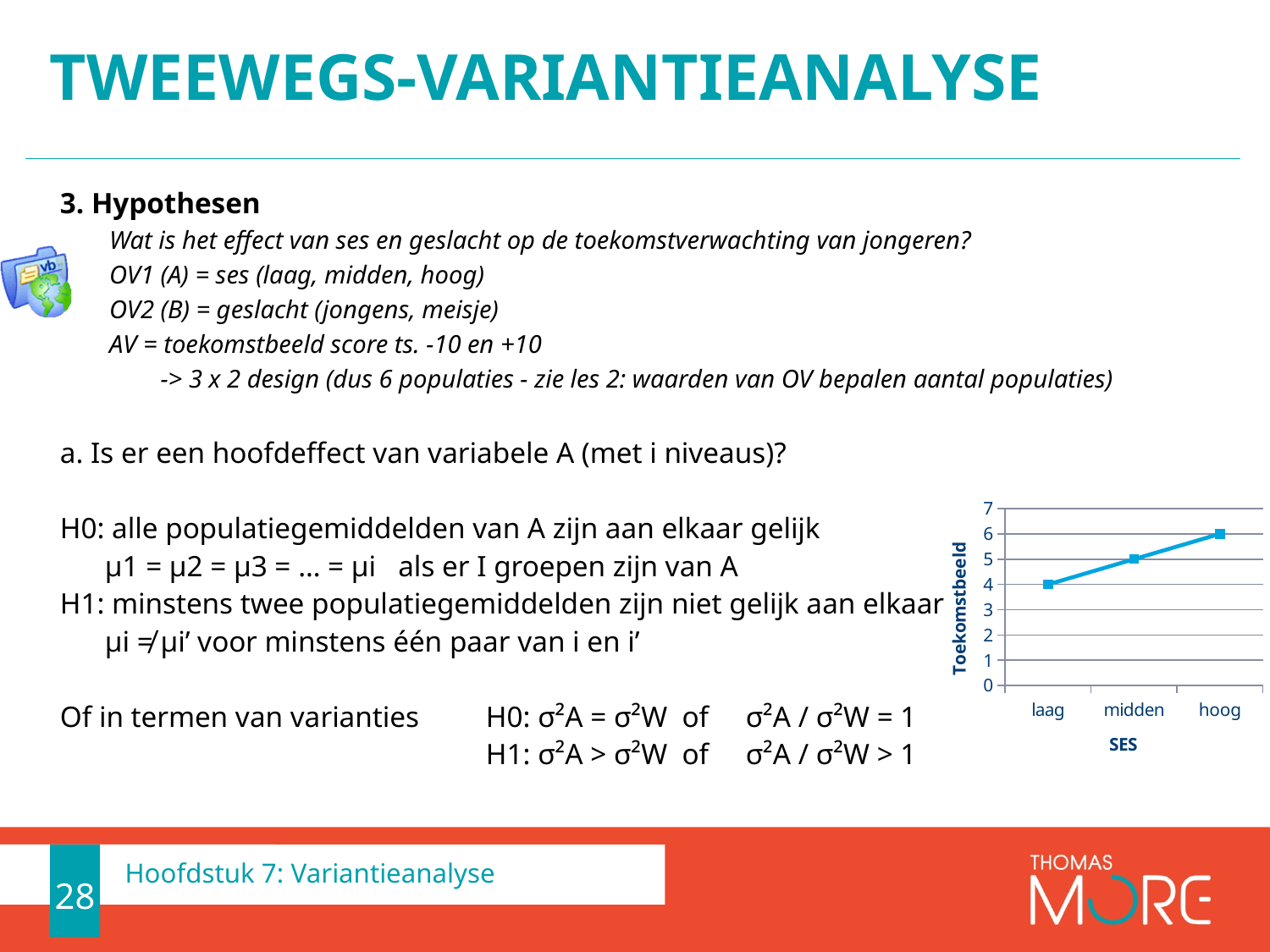
Which SES category has the lowest Toekomstbeeld value? laag Do the Toekomstbeeld values rise or fall from 'laag' to 'hoog'? rise Which SES category has the highest Toekomstbeeld value? hoog What is the Toekomstbeeld value for the SES category 'midden'? 5 What is the Toekomstbeeld value for the SES category 'hoog'? 6 What is the Toekomstbeeld value for the SES category 'laag'? 4 Is the Toekomstbeeld value for 'hoog' greater or less than 5? greater Which has a larger Toekomstbeeld value, 'midden' or 'laag'? midden How many SES categories are plotted on the x axis? 3 What kind of chart is shown on the slide? line chart What is the label of the y axis of the chart? Toekomstbeeld What is the difference in Toekomstbeeld between 'hoog' and 'laag'? 2